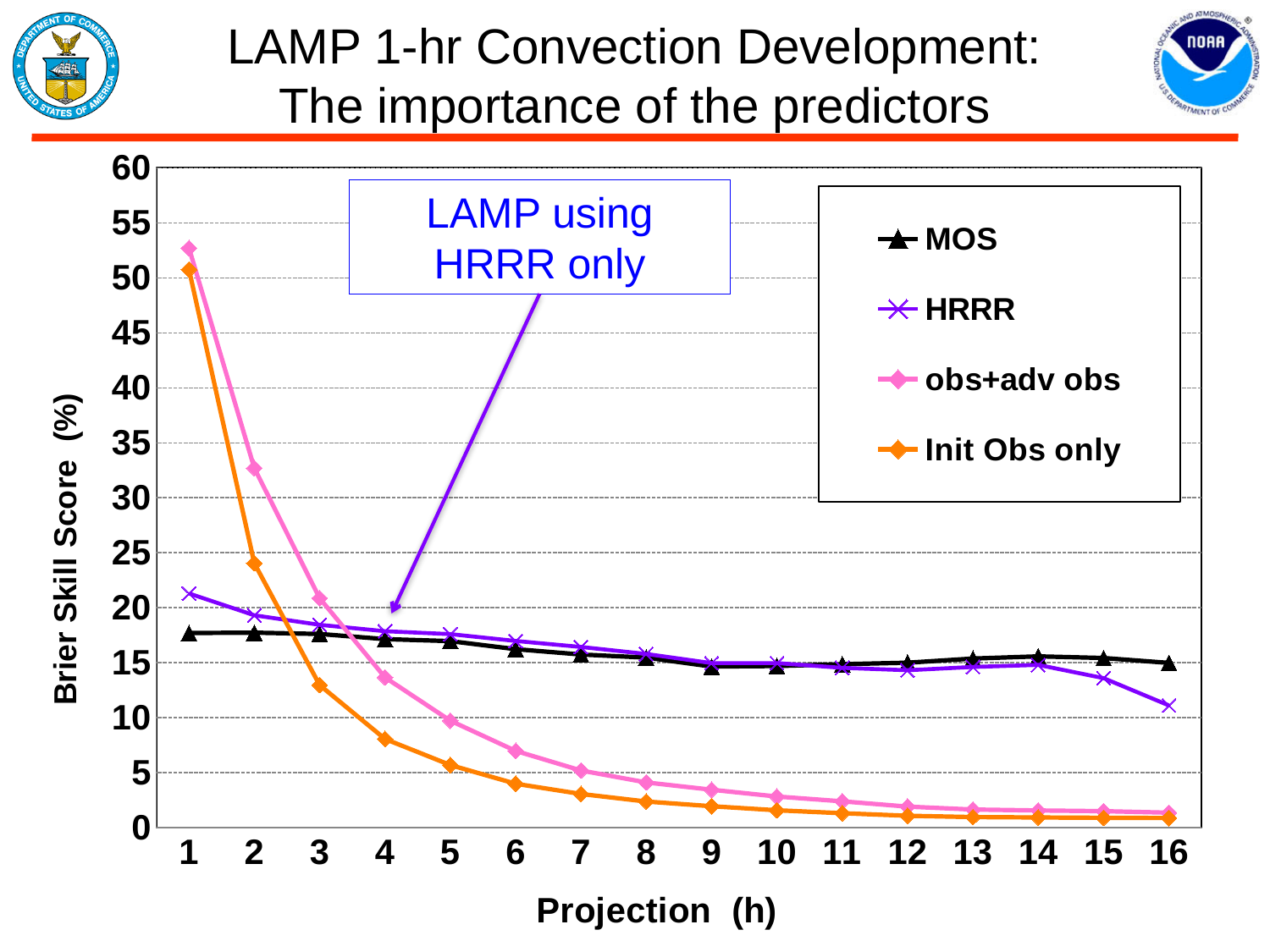
At projection 1, which is higher, obs+adv obs or MOS? obs+adv obs Which series has the highest value at projection 16? MOS What is the label of the y axis? Brier Skill Score (%) How many series does the legend list? 4 What kind of chart is shown on the slide? line chart Is the value for HRRR at projection 16 greater or less than 15? less Does the obs+adv obs series rise or fall as the projection hour increases? fall Is the value for MOS at projection 1 greater or less than 15? greater At projection 8, which is higher, MOS or Init Obs only? MOS How many projection hours are plotted along the x axis? 16 Is the value for obs+adv obs at projection 1 greater or less than 50? greater